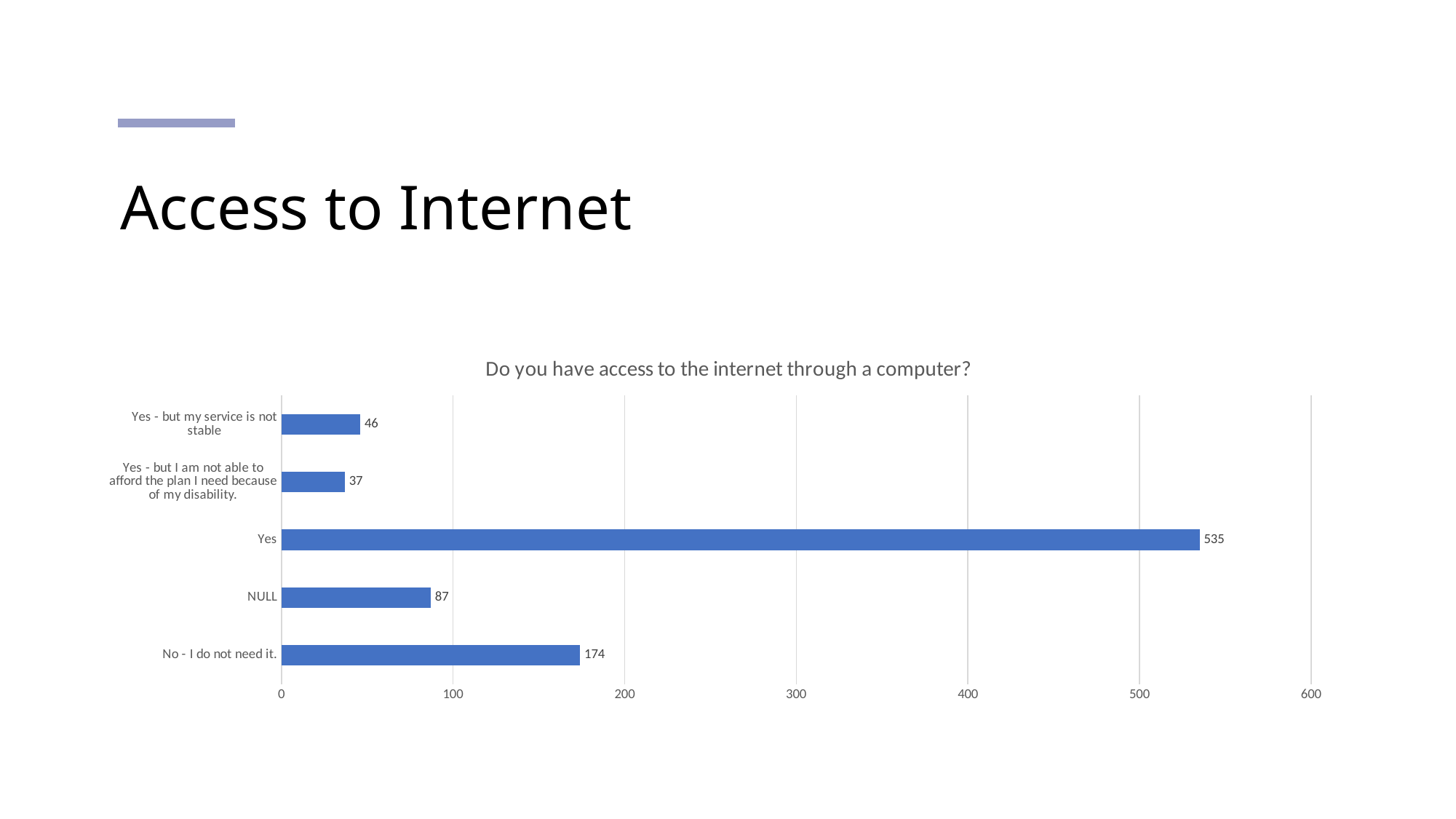
What kind of chart is shown on the slide? Bar chart How many categories are shown in the chart? 5 Which is larger, the value for "NULL" or the value for "Yes - but my service is not stable"? NULL What is the difference between the values for "Yes" and "No - I do not need it."? 361 What is the value for "Yes"? 535 Which category has the highest value? Yes What is the value for "No - I do not need it."? 174 What is the title of the chart? Do you have access to the internet through a computer? What is the value for "NULL"? 87 Which category has the lowest value? Yes - but I am not able to afford the plan I need because of my disability. What is the value for "Yes - but I am not able to afford the plan I need because of my disability."? 37 What is the value for "Yes - but my service is not stable"? 46